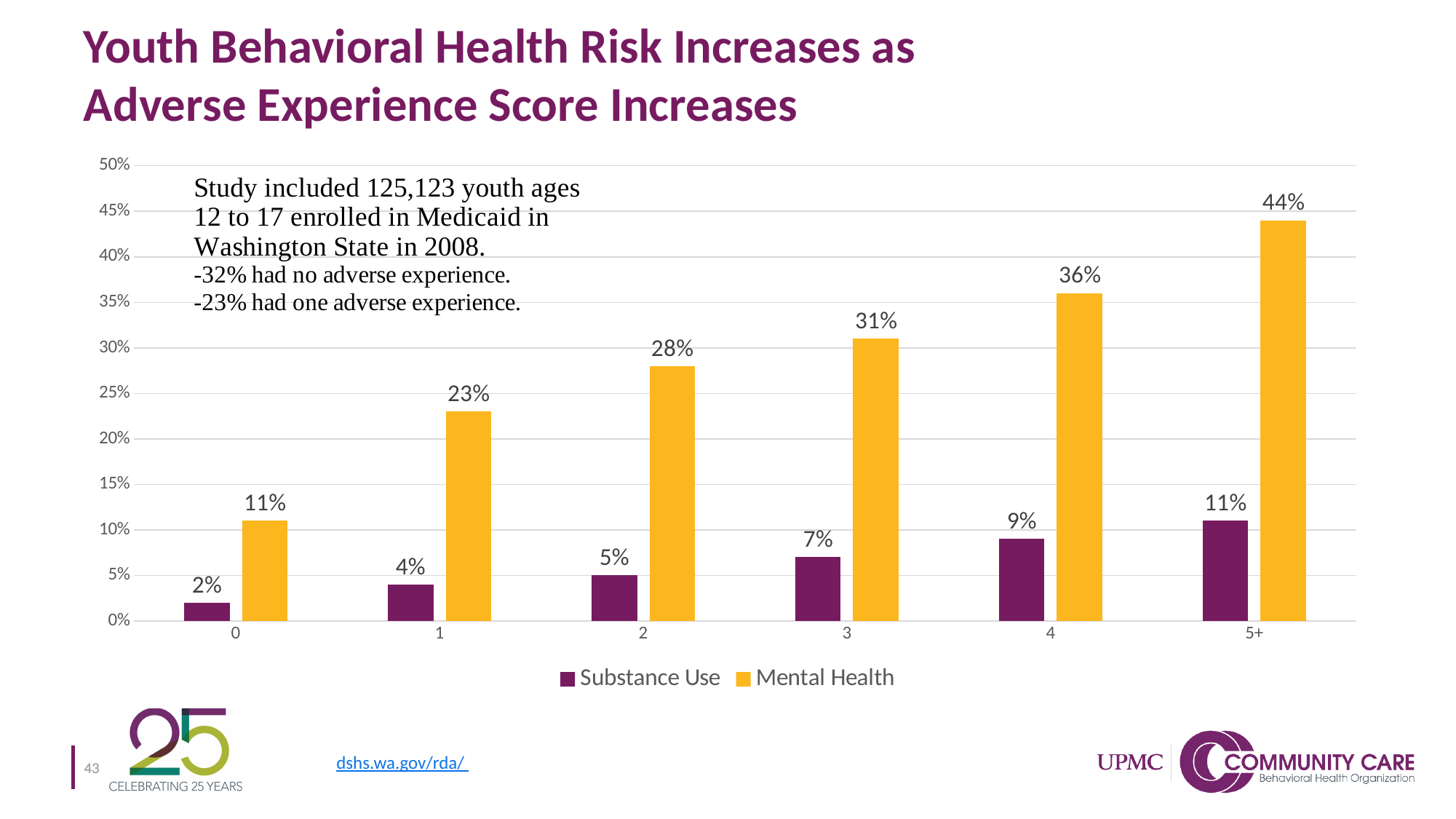
Which adverse experience score category has the lowest Substance Use value? 0 Which colour represents the Mental Health series? Yellow What is the Substance Use value for an adverse experience score of 4? 9% Which adverse experience score category has the highest Mental Health value? 5+ How many adverse experience score categories are shown on the x axis? 6 What is the Mental Health value for an adverse experience score of 3? 31% What kind of chart is shown on the slide? Bar chart What is the Mental Health value for a score of 5+? 44% How many series does the legend list? 2 Do the Substance Use values rise or fall as the adverse experience score increases? Rise Which is larger: the Mental Health value for a score of 1 or the Mental Health value for a score of 0? Mental Health for a score of 1 What is the difference between the Mental Health and Substance Use values for a score of 2? 23%